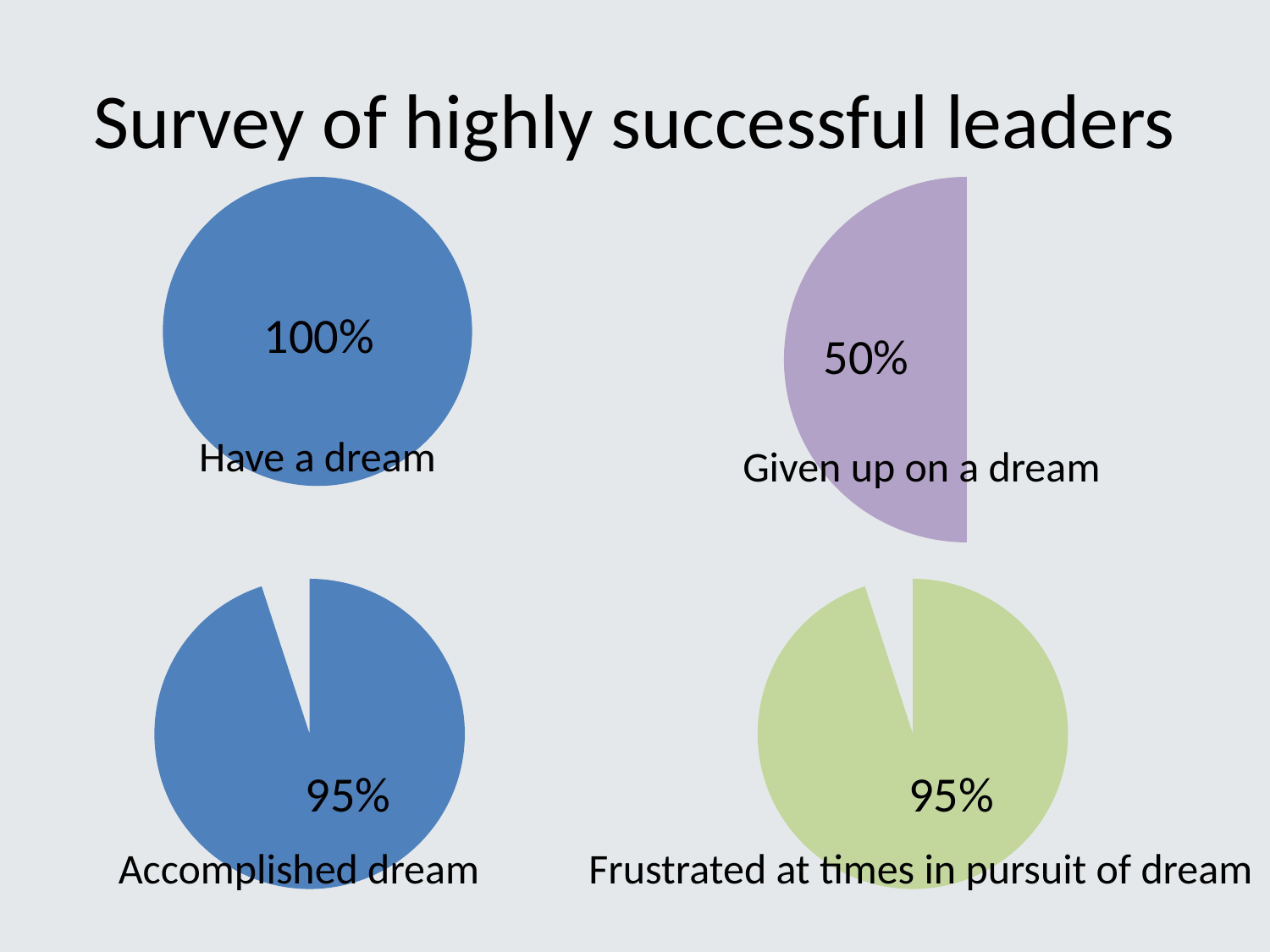
Which is larger, the percentage for 'Have a dream' or the percentage for 'Given up on a dream'? Have a dream On the 'Frustrated at times in pursuit of dream' chart, what percentage is shown? 95% What kind of chart is used for 'Given up on a dream'? Pie chart Of the four charts on the slide, which one shows the lowest percentage? Given up on a dream What colour is the slice in the 'Frustrated at times in pursuit of dream' chart? Green What is the difference between the 'Accomplished dream' percentage and the 'Given up on a dream' percentage? 45% On the 'Given up on a dream' chart, what percentage is shown? 50% What is the title of the slide containing the four pie charts? Survey of highly successful leaders On the 'Accomplished dream' chart, what percentage is shown? 95% On the 'Have a dream' chart, what percentage is shown? 100% What is the difference between the 'Have a dream' percentage and the 'Accomplished dream' percentage? 5% How many pie charts are on the slide? 4